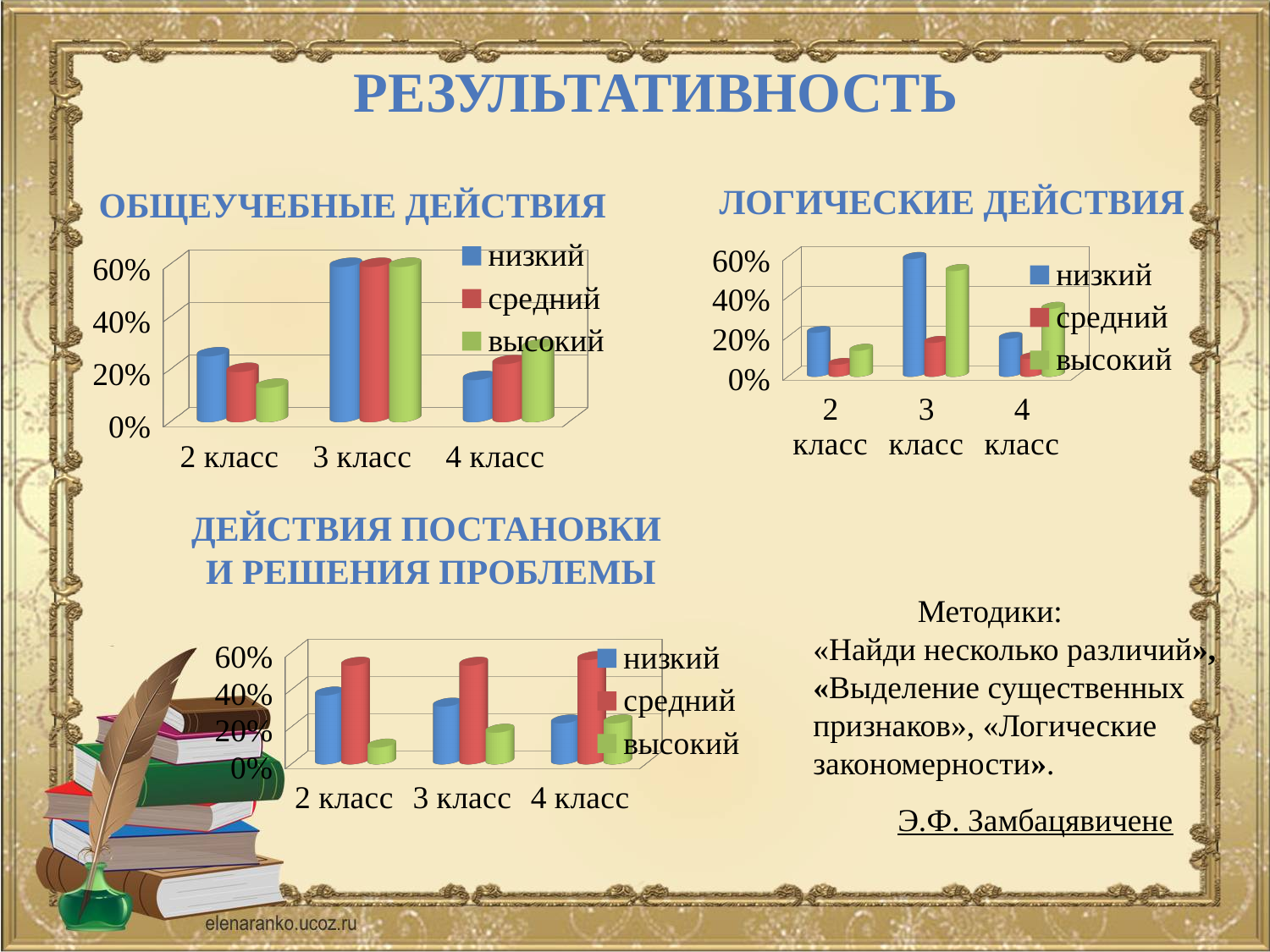
In the "ДЕЙСТВИЯ ПОСТАНОВКИ И РЕШЕНИЯ ПРОБЛЕМЫ" chart, which is larger in 4 класс: "низкий" or "средний"? средний What colour represents the "высокий" series in the "ОБЩЕУЧЕБНЫЕ ДЕЙСТВИЯ" chart? green In the "ДЕЙСТВИЯ ПОСТАНОВКИ И РЕШЕНИЯ ПРОБЛЕМЫ" chart, does the value for "низкий" rise or fall from 2 класс to 4 класс? fall In the "ЛОГИЧЕСКИЕ ДЕЙСТВИЯ" chart, which category has the highest value for "низкий"? 3 класс In the "ЛОГИЧЕСКИЕ ДЕЙСТВИЯ" chart, is the value for "высокий" in 4 класс greater or less than 20%? greater How many categories are shown on the x axis of the "ЛОГИЧЕСКИЕ ДЕЙСТВИЯ" chart? 3 In the "ОБЩЕУЧЕБНЫЕ ДЕЙСТВИЯ" chart, is the value for "низкий" in 3 класс greater or less than 40%? greater In the "ОБЩЕУЧЕБНЫЕ ДЕЙСТВИЯ" chart, is the value for "высокий" in 2 класс greater or less than 20%? less What kind of chart is the "ОБЩЕУЧЕБНЫЕ ДЕЙСТВИЯ" chart? bar chart How many series does the legend of the "ДЕЙСТВИЯ ПОСТАНОВКИ И РЕШЕНИЯ ПРОБЛЕМЫ" chart list? 3 In the "ЛОГИЧЕСКИЕ ДЕЙСТВИЯ" chart, which category has the lowest value for "средний"? 2 класс In the "ДЕЙСТВИЯ ПОСТАНОВКИ И РЕШЕНИЯ ПРОБЛЕМЫ" chart, which series has the highest value in 2 класс? средний